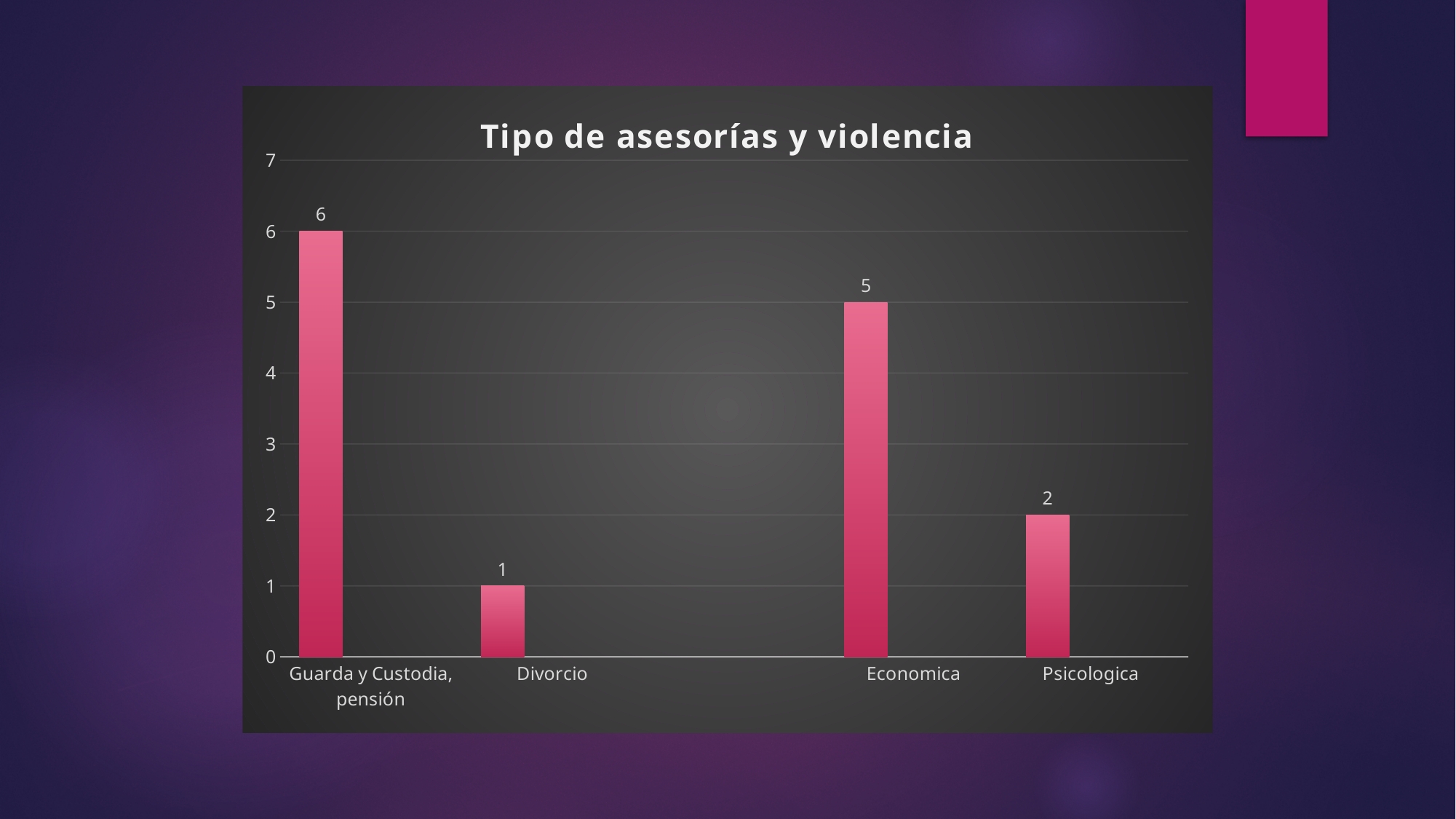
Which category has the lowest value? Divorcio How many categories are shown on the x axis? 4 What is the value for Guarda y Custodia, pensión? 6 What is the title of the chart? Tipo de asesorías y violencia What is the value for Divorcio? 1 Which is larger, the value for Psicologica or the value for Divorcio? Psicologica What is the difference between the values for Economica and Psicologica? 3 Which category has the highest value? Guarda y Custodia, pensión What is the value for Economica? 5 What is the value for Psicologica? 2 What is the difference between the values for Guarda y Custodia, pensión and Economica? 1 What kind of chart is shown on the slide? Bar chart